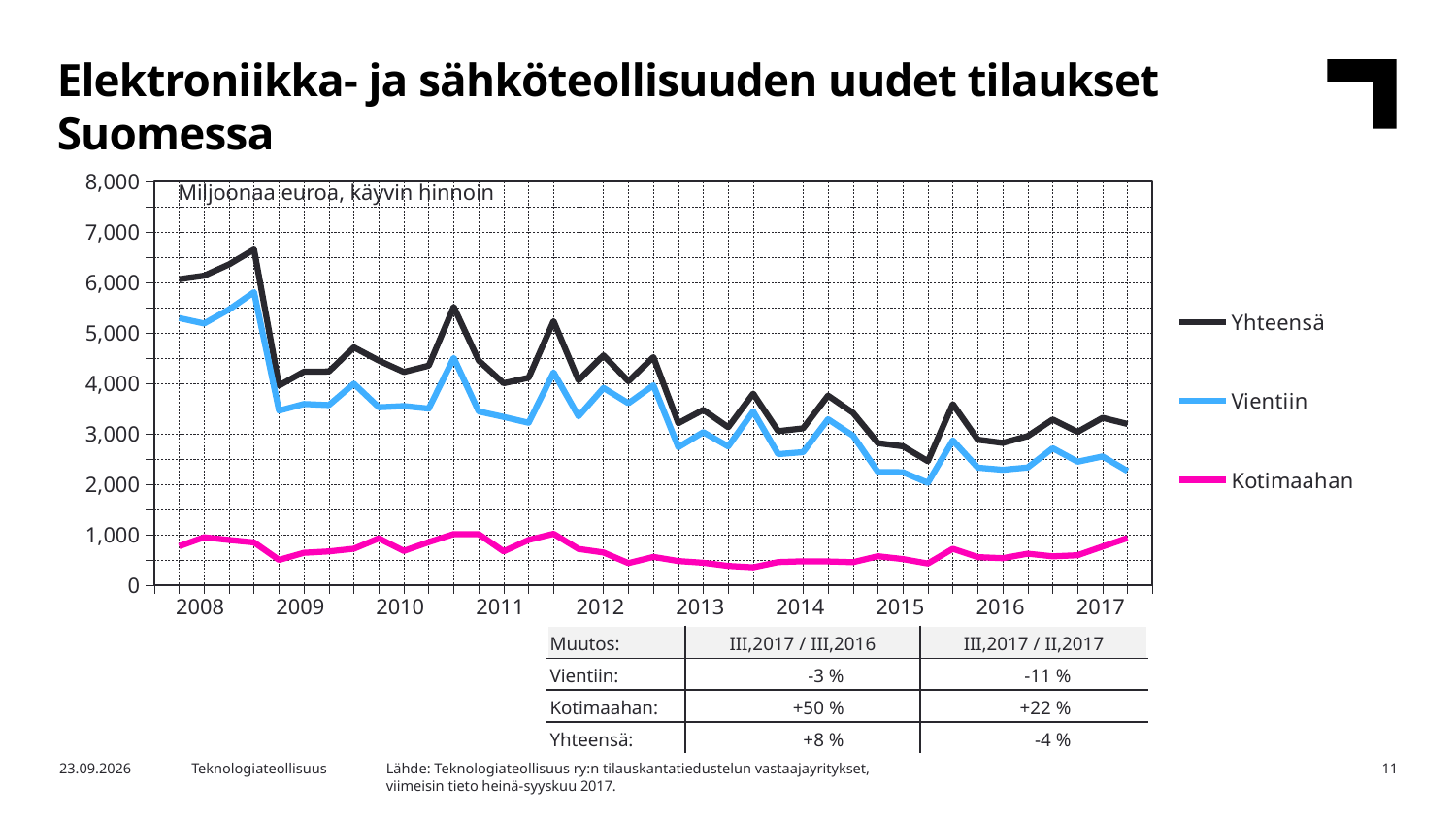
Does the Yhteensä line generally rise or fall from 2008 to 2017? fall What unit is stated at the top of the chart area? Miljoonaa euroa, käyvin hinnoin How many series does the legend list? 3 Which series has the lowest values throughout the chart? Kotimaahan Is the value for Kotimaahan in 2012 greater or less than 2,000? less Is the value for Yhteensä at the start of 2008 greater or less than 5,000? greater In which year does the Yhteensä line reach its highest point? 2008 Is the value for Vientiin at the end of 2017 greater or less than 3,000? less Which series has the highest values throughout the chart? Yhteensä What kind of chart is shown on the slide? Line chart How many years are labelled on the x axis? 10 Which series are listed in the legend? Yhteensä, Vientiin, Kotimaahan